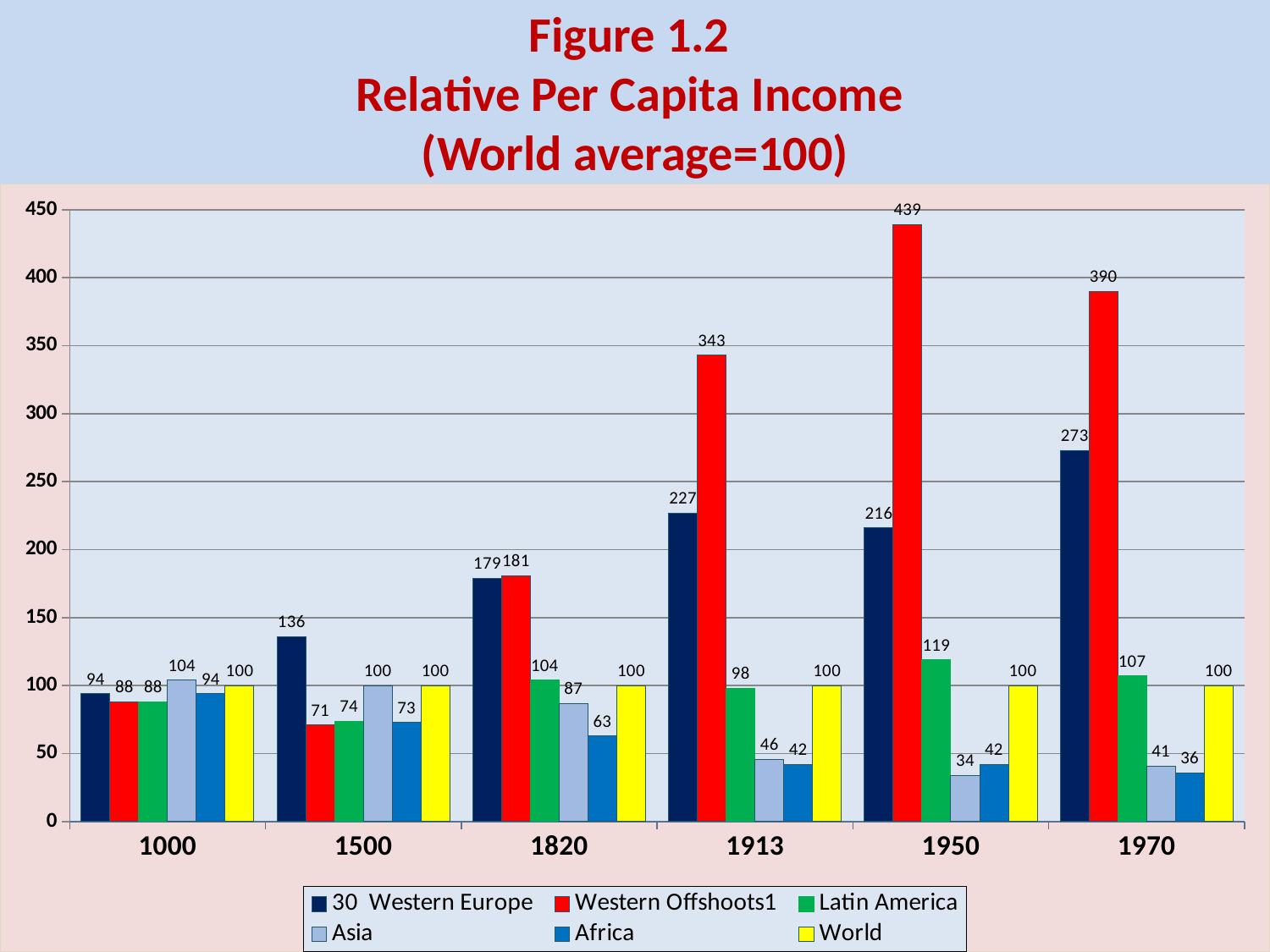
How many years are shown on the x axis? 6 How many series does the legend list? 6 In which year does Western Offshoots1 reach its highest value? 1950 What is the value for Asia in 1820? 87 Which series has the lowest value in 1950? Asia Does the value for Asia rise or fall from 1000 to 1950? Fall Which is larger in 1500: 30 Western Europe or Western Offshoots1? 30 Western Europe What kind of chart is shown on the slide? Bar chart What is the value for Western Offshoots1 in 1950? 439 What is the value for Africa in 1970? 36 Is the value for Western Offshoots1 in 1970 greater or less than 350? greater What is the difference between Western Offshoots1 and 30 Western Europe in 1913? 116